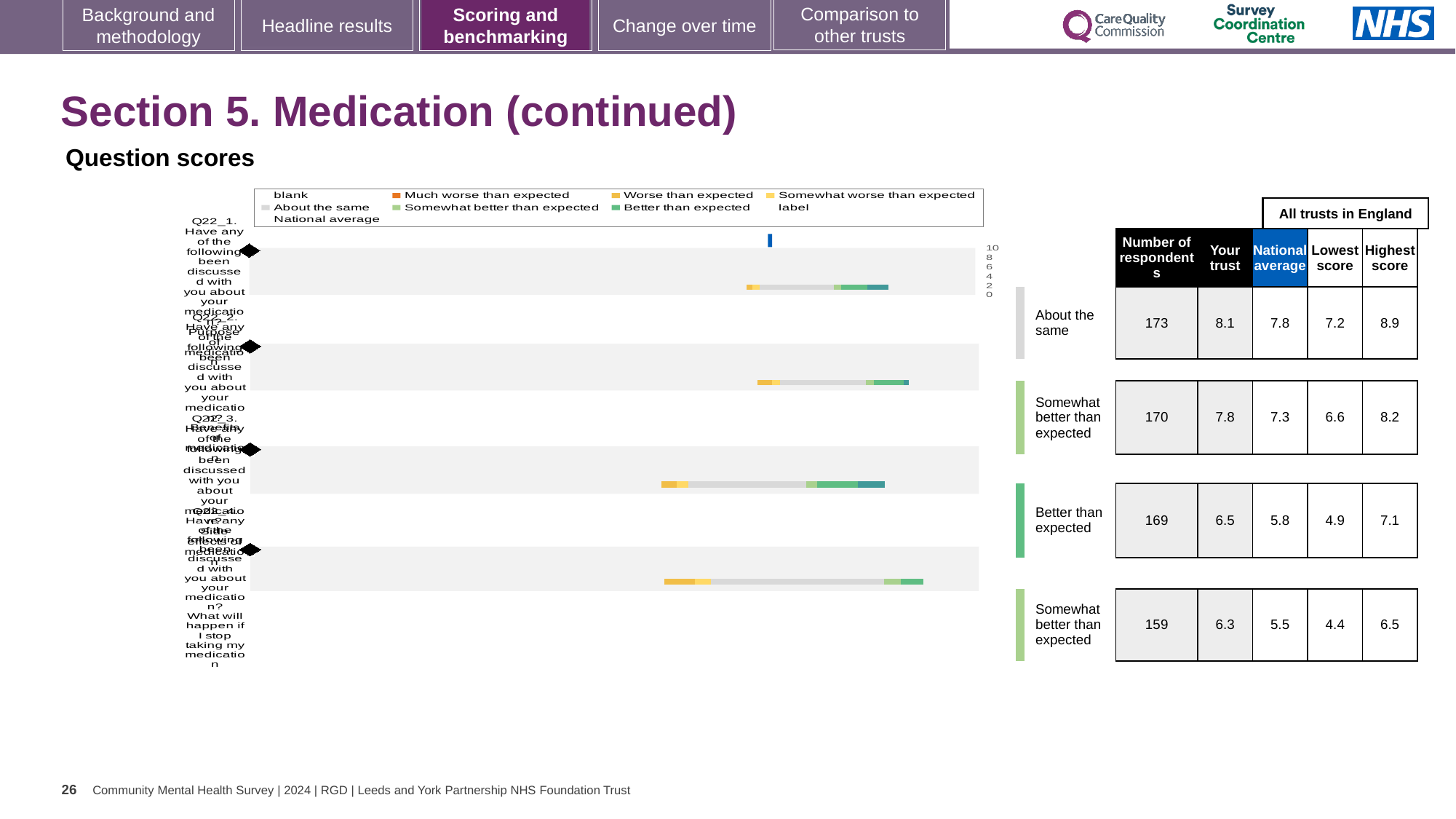
What benchmark category is shown for the third question row? Better than expected In the chart legend, what colour represents 'Much worse than expected'? Orange What is the 'Your trust' score for the third question row? 6.5 How many question rows (bars) are plotted in the chart? 4 Which question row has the highest 'Your trust' score? The first (top) row, 8.1 For the second question row, which is larger: the 'Your trust' score or the national average? Your trust (7.8) What is the number of respondents for the first (top) question row? 173 What is the highest score among all trusts in England for the fourth question row? 6.5 In the chart legend, what colour represents 'Better than expected'? Teal green Which question row has the lowest number of respondents? The fourth (bottom) row, 159 For the first question row, what is the difference between the 'Your trust' score and the national average? 0.3 What kind of chart is shown on the slide? Bar chart